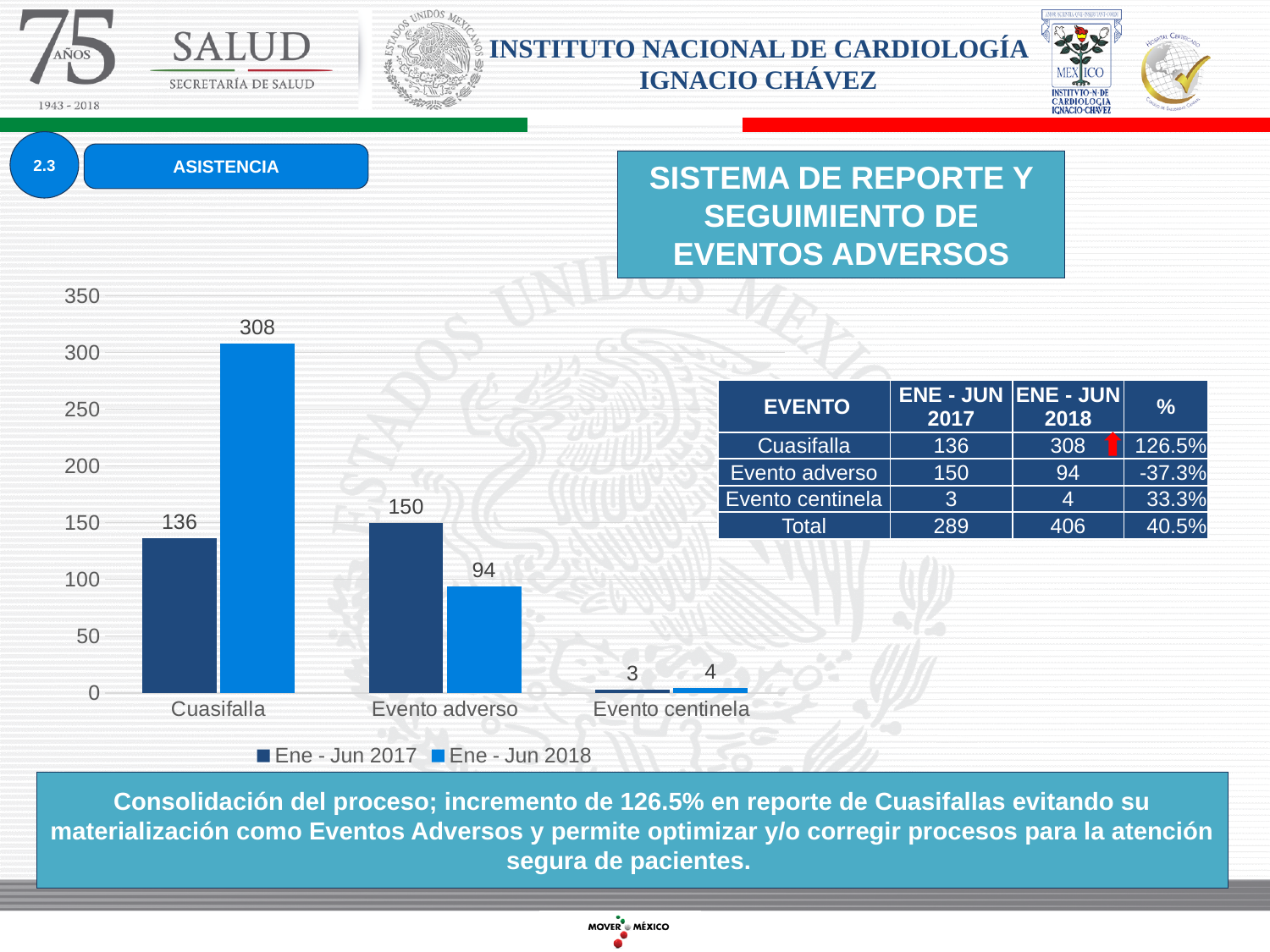
What is the difference between the Ene - Jun 2018 and Ene - Jun 2017 values for Cuasifalla? 172 What is the value for Evento adverso in the Ene - Jun 2017 series? 150 What is the difference between the Ene - Jun 2017 and Ene - Jun 2018 values for Evento adverso? 56 Is the value for Cuasifalla in Ene - Jun 2018 greater or less than 300? greater What is the value for Cuasifalla in the Ene - Jun 2018 series? 308 How many series does the chart legend list? 2 Which category has the highest value in the Ene - Jun 2018 series? Cuasifalla Which is larger for Evento adverso: the Ene - Jun 2017 value or the Ene - Jun 2018 value? Ene - Jun 2017 How many categories are shown on the x axis of the chart? 3 What is the value for Evento centinela in the Ene - Jun 2018 series? 4 What kind of chart is shown on the slide? bar chart Which category has the lowest value in the Ene - Jun 2017 series? Evento centinela